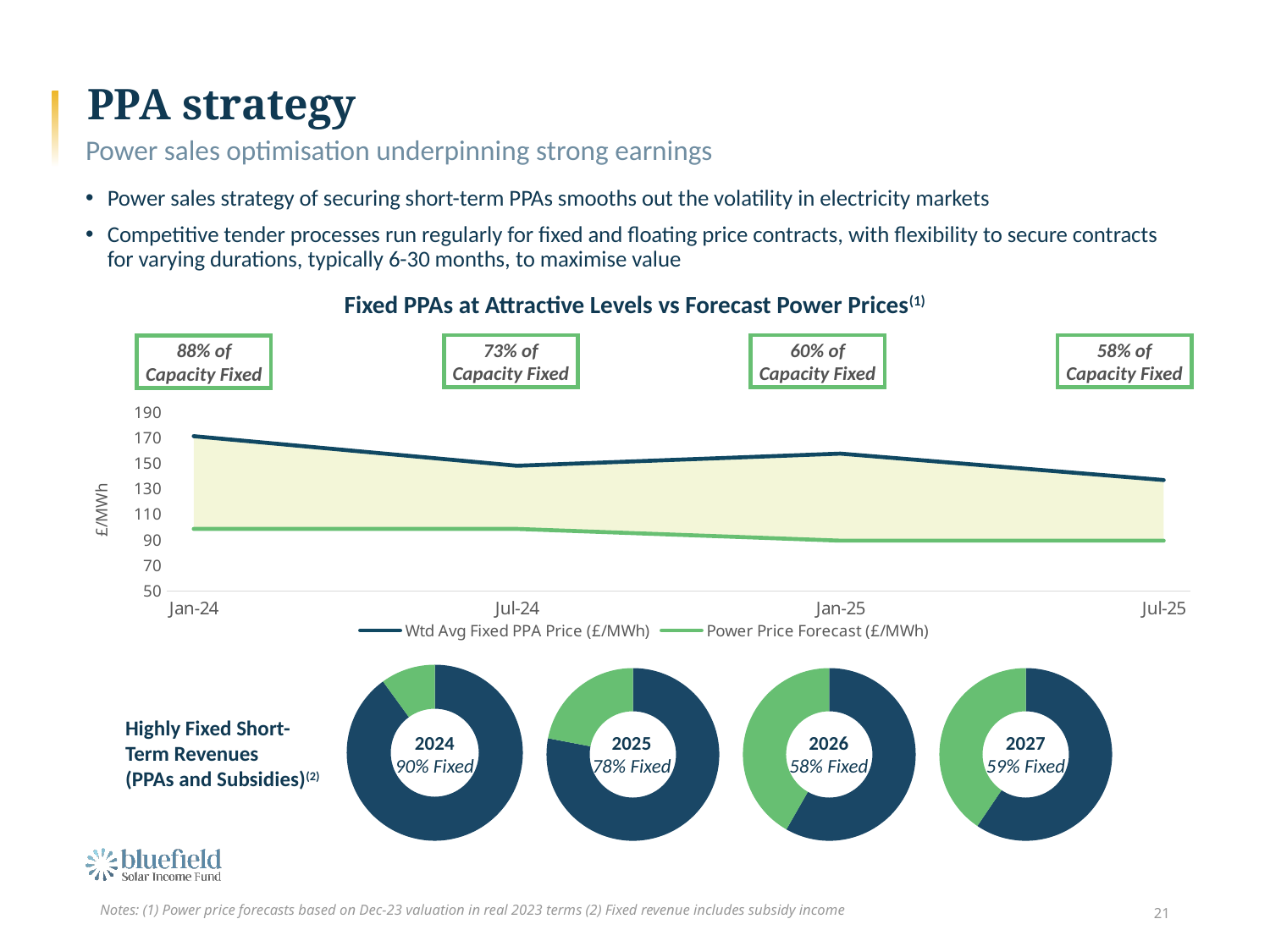
In the 'Fixed PPAs at Attractive Levels vs Forecast Power Prices' chart, what percentage of capacity is fixed at Jul-24 according to the annotation box? 73% What kind of chart is 'Fixed PPAs at Attractive Levels vs Forecast Power Prices'? Line chart In the 'Fixed PPAs at Attractive Levels vs Forecast Power Prices' chart, what are the two legend entries? Wtd Avg Fixed PPA Price (£/MWh) and Power Price Forecast (£/MWh) In the 'Highly Fixed Short-Term Revenues' donut charts, what share of revenues is fixed for 2025? 78% Fixed How many series does the legend of the 'Fixed PPAs at Attractive Levels vs Forecast Power Prices' chart list? 2 In the 'Fixed PPAs at Attractive Levels vs Forecast Power Prices' chart, is the Power Price Forecast at Jan-24 greater or less than 110? less In the 'Fixed PPAs at Attractive Levels vs Forecast Power Prices' chart, does the Power Price Forecast rise or fall from Jan-24 to Jul-25? Fall In the 'Fixed PPAs at Attractive Levels vs Forecast Power Prices' chart, is the Wtd Avg Fixed PPA Price at Jul-25 greater or less than 150? less In the 'Fixed PPAs at Attractive Levels vs Forecast Power Prices' chart, is the Wtd Avg Fixed PPA Price at Jan-24 greater or less than 150? greater In the 'Fixed PPAs at Attractive Levels vs Forecast Power Prices' chart, which series is higher at Jan-25: Wtd Avg Fixed PPA Price or Power Price Forecast? Wtd Avg Fixed PPA Price How many dates are labelled on the x axis of the 'Fixed PPAs at Attractive Levels vs Forecast Power Prices' chart? 4 Among the 'Highly Fixed Short-Term Revenues' donut charts, which year has the highest fixed share? 2024